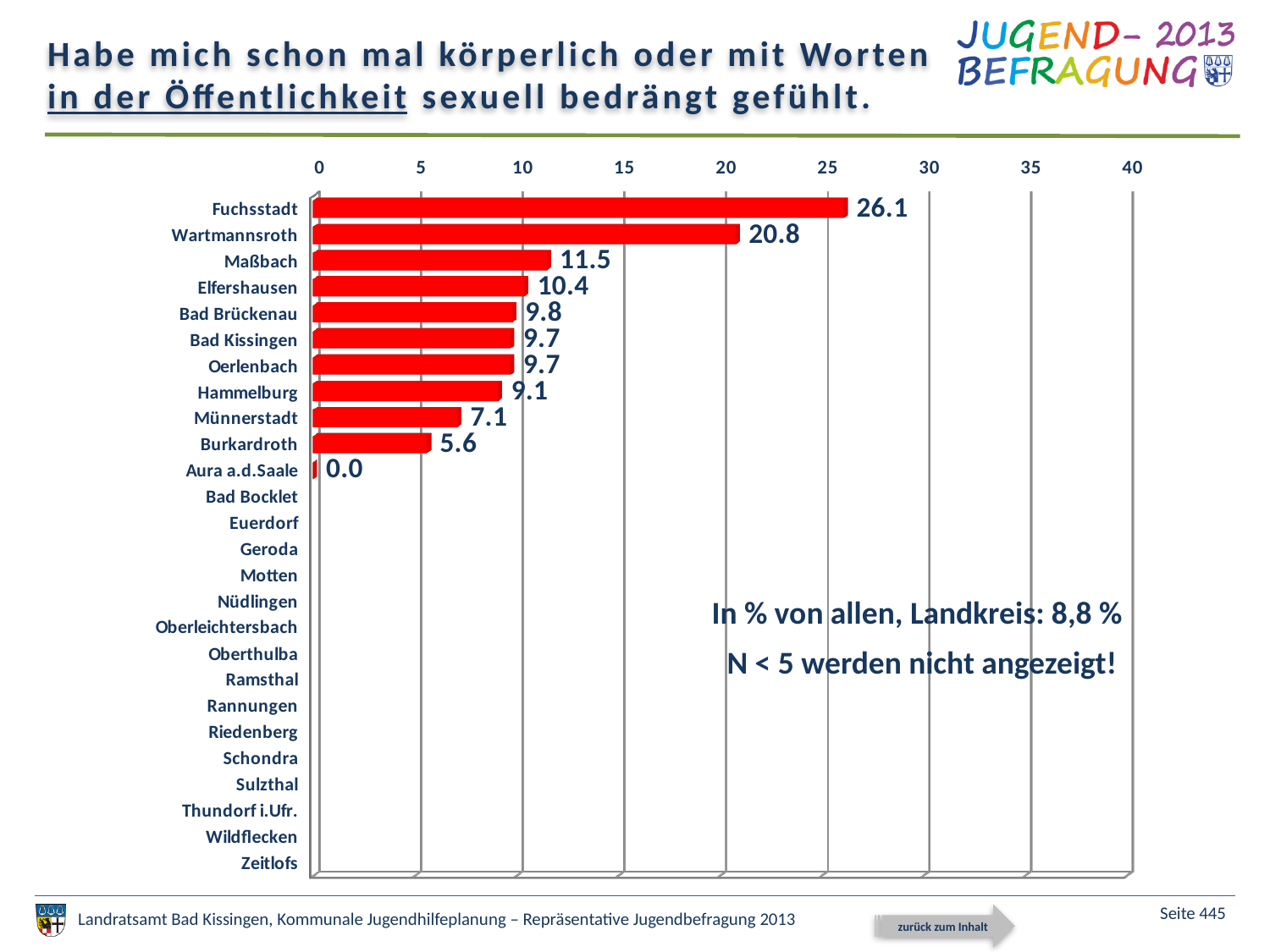
What kind of chart is shown on the slide? Bar chart What is the value for Fuchsstadt? 26.1 According to the note on the chart, what is the value for the Landkreis as a whole? 8,8 % What is the difference between the values for Fuchsstadt and Wartmannsroth? 5.3 Which municipality has the highest value in the chart? Fuchsstadt What is the value for Hammelburg? 9.1 What is the difference between the values for Maßbach and Elfershausen? 1.1 What is the value for Burkardroth? 5.6 Is the value for Wartmannsroth greater or less than 15? greater Which is larger, the value for Münnerstadt or the value for Burkardroth? Münnerstadt How many municipalities have a data label displayed in the chart? 11 Which municipality with a displayed value has the lowest value? Aura a.d.Saale